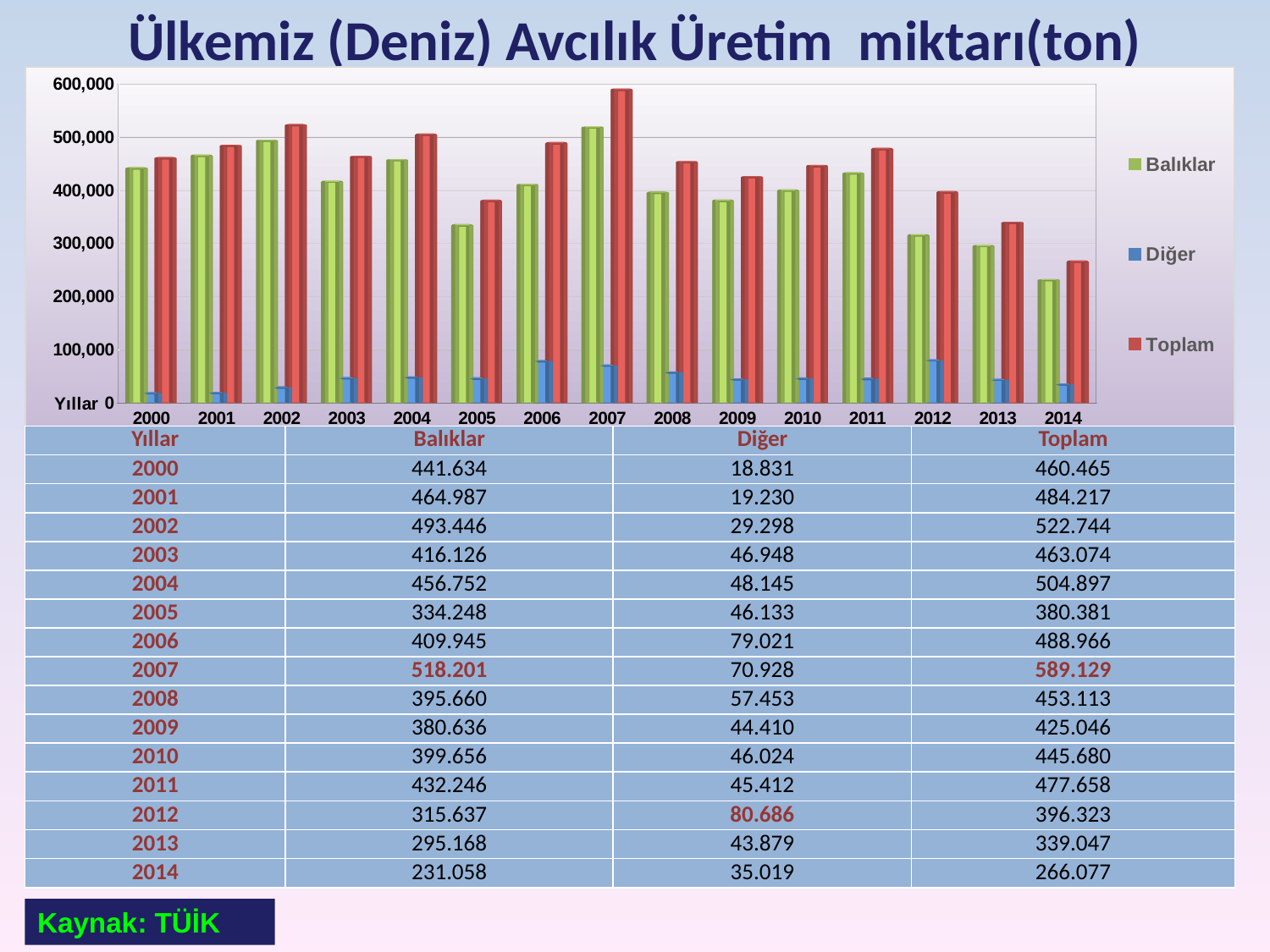
What is the title of the chart? Ülkemiz (Deniz) Avcılık Üretim miktarı(ton) Which year has the highest Toplam value? 2007 Is the Toplam value for 2014 greater or less than 300,000? less Which year has the lowest Balıklar value? 2014 What is the Toplam value for 2007? 589.129 Which is larger, the Balıklar value for 2002 or the Balıklar value for 2005? 2002 What is the Diğer value for 2012? 80.686 How many series does the chart legend list? 3 How many years are shown on the x axis of the chart? 15 Does the Toplam value rise or fall from 2011 to 2014? fall What kind of chart is shown on the slide? bar chart What is the Balıklar value for 2000? 441.634